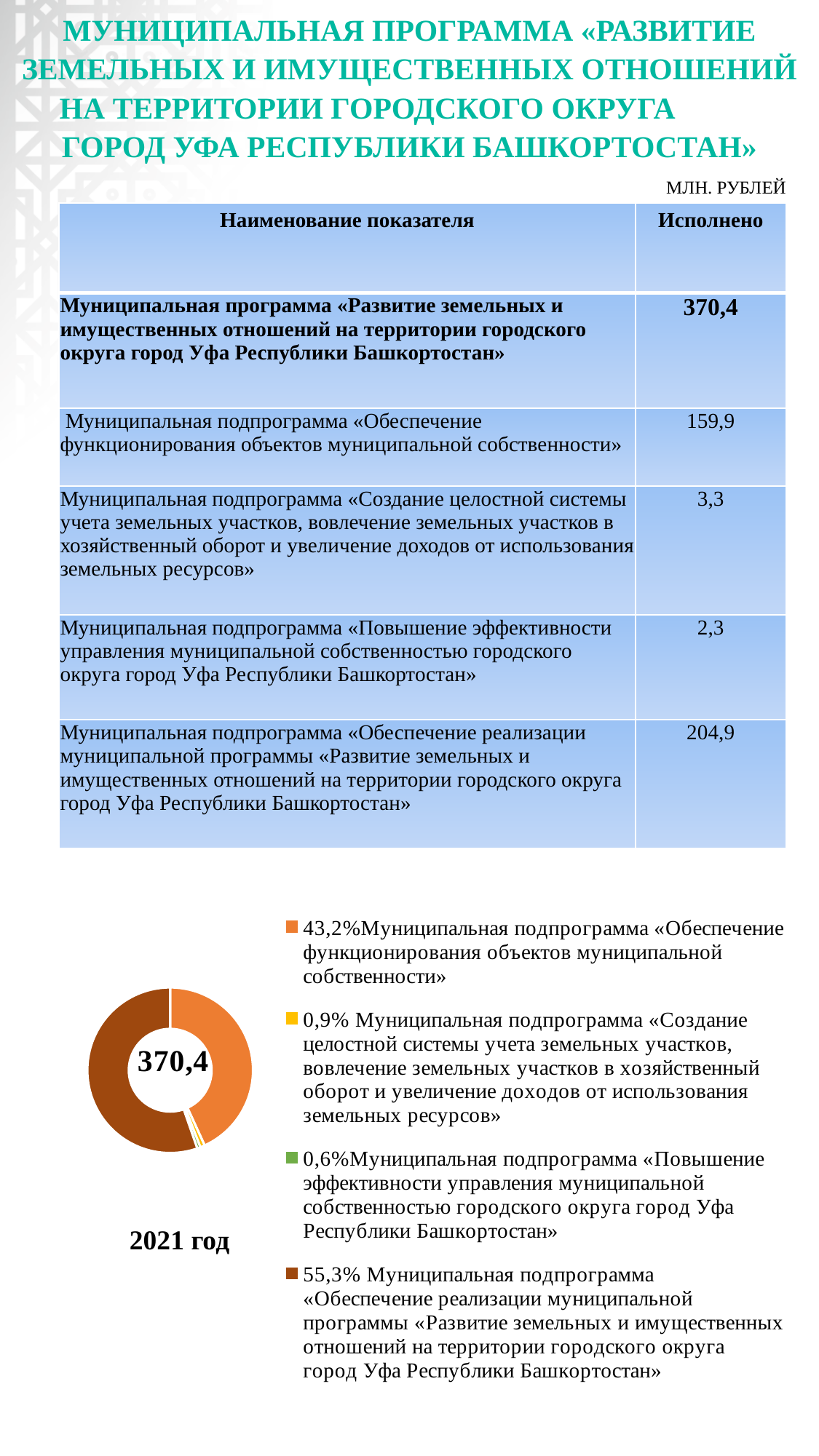
Which subprogram has the largest share in the doughnut chart? Муниципальная подпрограмма «Обеспечение реализации муниципальной программы «Развитие земельных и имущественных отношений на территории городского округа город Уфа Республики Башкортостан» In the doughnut chart, which share is larger: «Обеспечение функционирования объектов муниципальной собственности» or «Обеспечение реализации муниципальной программы...»? «Обеспечение реализации муниципальной программы...» (55,3%) Which subprogram has the smallest share in the doughnut chart? Муниципальная подпрограмма «Повышение эффективности управления муниципальной собственностью городского округа город Уфа Республики Башкортостан» What share of the doughnut chart does the subprogram «Повышение эффективности управления муниципальной собственностью...» have? 0,6% What share of the doughnut chart does the subprogram «Обеспечение реализации муниципальной программы...» have? 55,3% How many slices does the doughnut chart have? 4 What share of the doughnut chart does the subprogram «Обеспечение функционирования объектов муниципальной собственности» have? 43,2% Which year is labelled under the doughnut chart? 2021 год What is the difference in percentage points between the 55,3% slice and the 43,2% slice in the doughnut chart? 12,1 What kind of chart is shown at the bottom of the slide? pie chart (doughnut) What total value is printed in the centre of the doughnut chart? 370,4